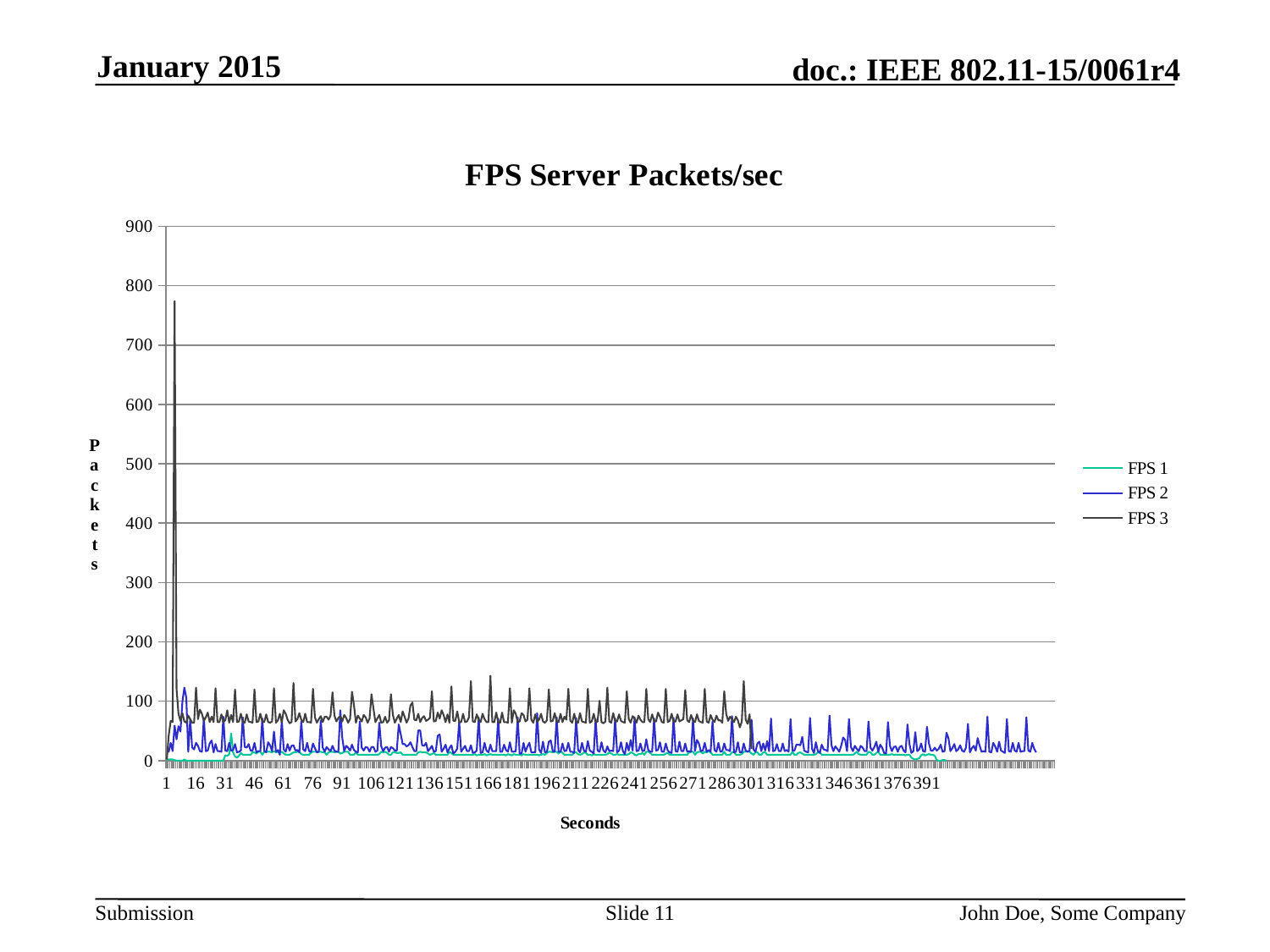
Is the highest peak of FPS 3 greater or less than 800? less What is the highest value shown on the y axis? 900 What is the label of the x axis? Seconds Is the highest peak of FPS 3 greater or less than 700? greater How many series does the legend list? 3 Is the highest value of FPS 2 greater or less than 200? less Which series has the larger peak value, FPS 2 or FPS 3? FPS 3 What is the title of the chart? FPS Server Packets/sec Which series reaches the highest peak value on the chart? FPS 3 What kind of chart is shown on the slide? line chart Which series stays lowest across the chart? FPS 1